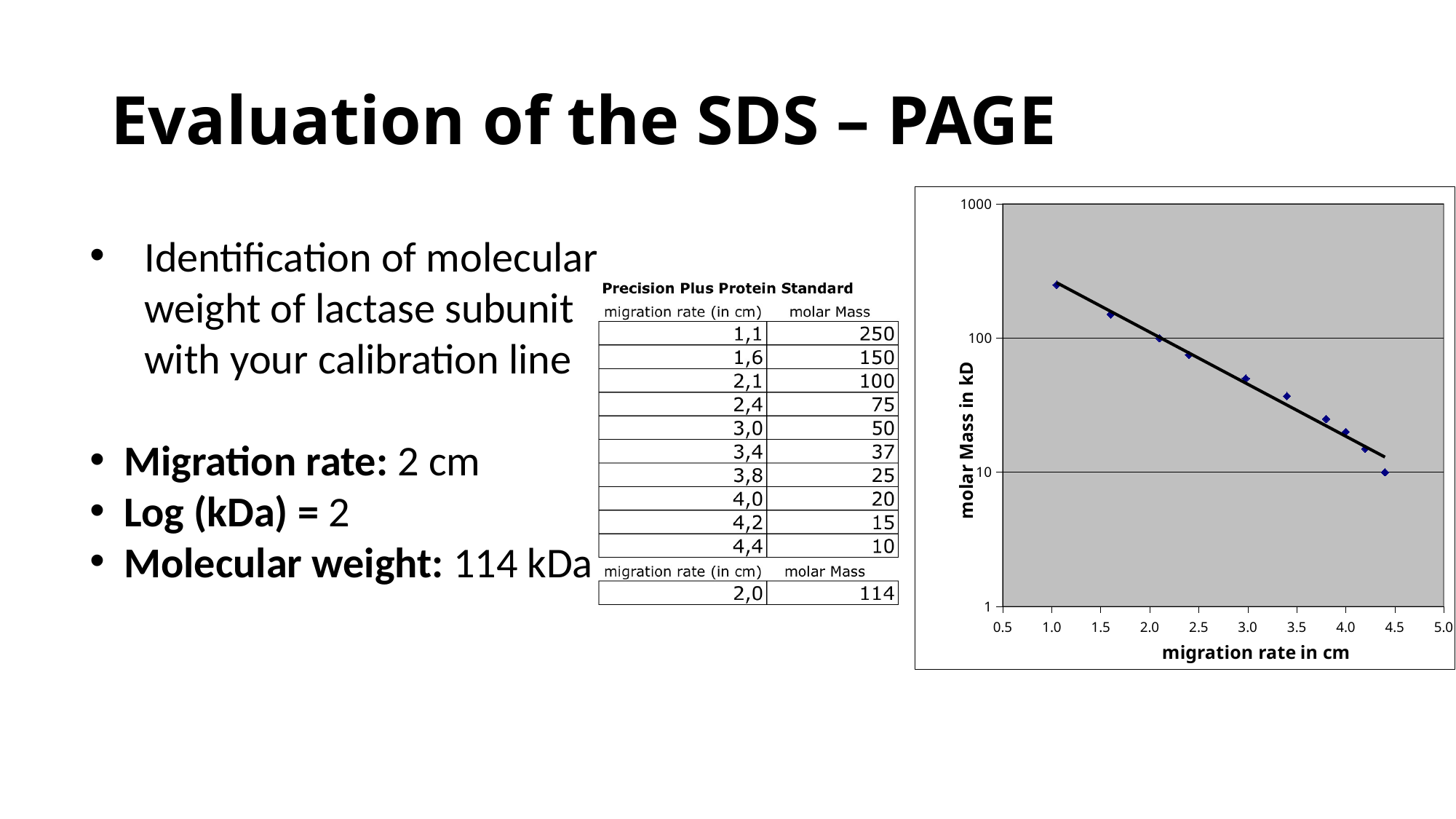
At which migration rate does the plotted point with the lowest molar mass lie? 4.4 cm Is the molar mass of the point at a migration rate of 4.0 cm greater or less than 10? greater Is the molar mass of the point at a migration rate of 3.0 cm greater or less than 100? less Which plotted point has the highest molar mass: the one at the smallest migration rate or the one at the largest migration rate? the one at the smallest migration rate Do the plotted values rise or fall as the migration rate increases along the x axis? fall Is the molar mass of the point at a migration rate of about 1.0 cm greater or less than 100? greater Which point has the larger molar mass: the one at a migration rate of about 1.6 cm or the one at about 3.4 cm? the one at about 1.6 cm What is the title of the y axis of the chart? molar Mass in kD What is the title of the x axis of the chart? migration rate in cm How many data points are plotted on the chart? 10 What kind of chart is shown on the slide? scatter chart